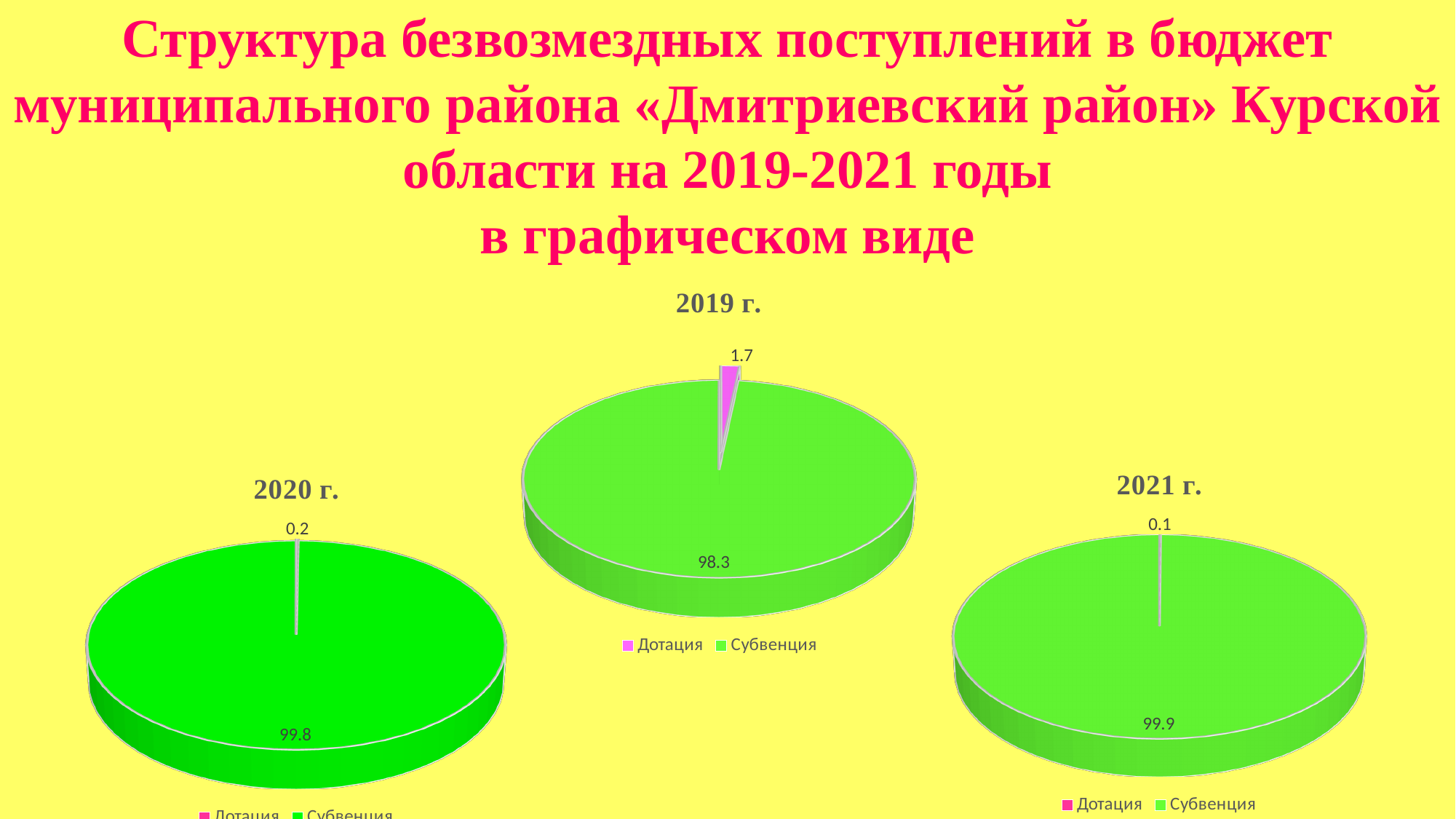
In the "2019 г." chart, what is the value for Дотация? 1.7 How many pie charts are shown on the slide? 3 In the "2019 г." chart, which category has the smallest slice? Дотация Which is larger: the Дотация value in the "2019 г." chart or the Дотация value in the "2020 г." chart? 2019 г. In the "2021 г." chart, what is the value for Субвенция? 99.9 In the "2021 г." chart, what is the value for Дотация? 0.1 In the "2020 г." chart, which category has the largest slice? Субвенция What type of chart is the "2021 г." chart? Pie chart In the "2020 г." chart, what is the value for Субвенция? 99.8 In the "2019 г." chart, what is the value for Субвенция? 98.3 In the "2019 г." chart, what is the difference between the Субвенция and Дотация values? 96.6 How many slices does the "2020 г." chart have? 2